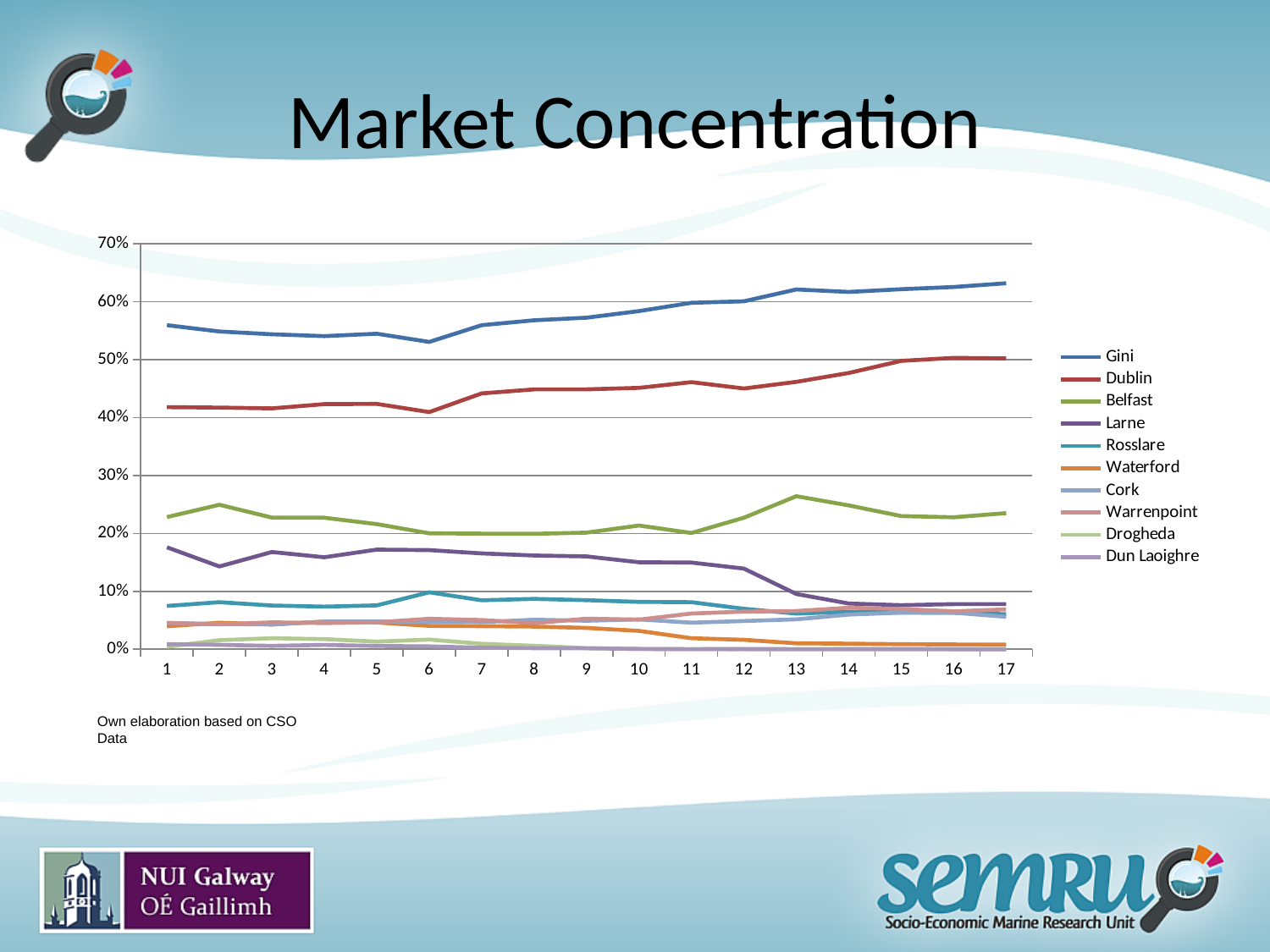
Is the value for Larne at point 17 greater or less than 10%? less Is the value for Gini at point 17 greater or less than 60%? greater How many series does the legend list? 10 At point 1, which is larger, the value for Belfast or the value for Larne? Belfast Which series is plotted highest across the whole chart? Gini Does the Gini series rise or fall from point 1 to point 17? Rise Does the Larne series rise or fall from point 1 to point 17? Fall What kind of chart is shown on the slide? Line chart What is the title of the slide containing the chart? Market Concentration How many points are plotted along the x axis for each series? 17